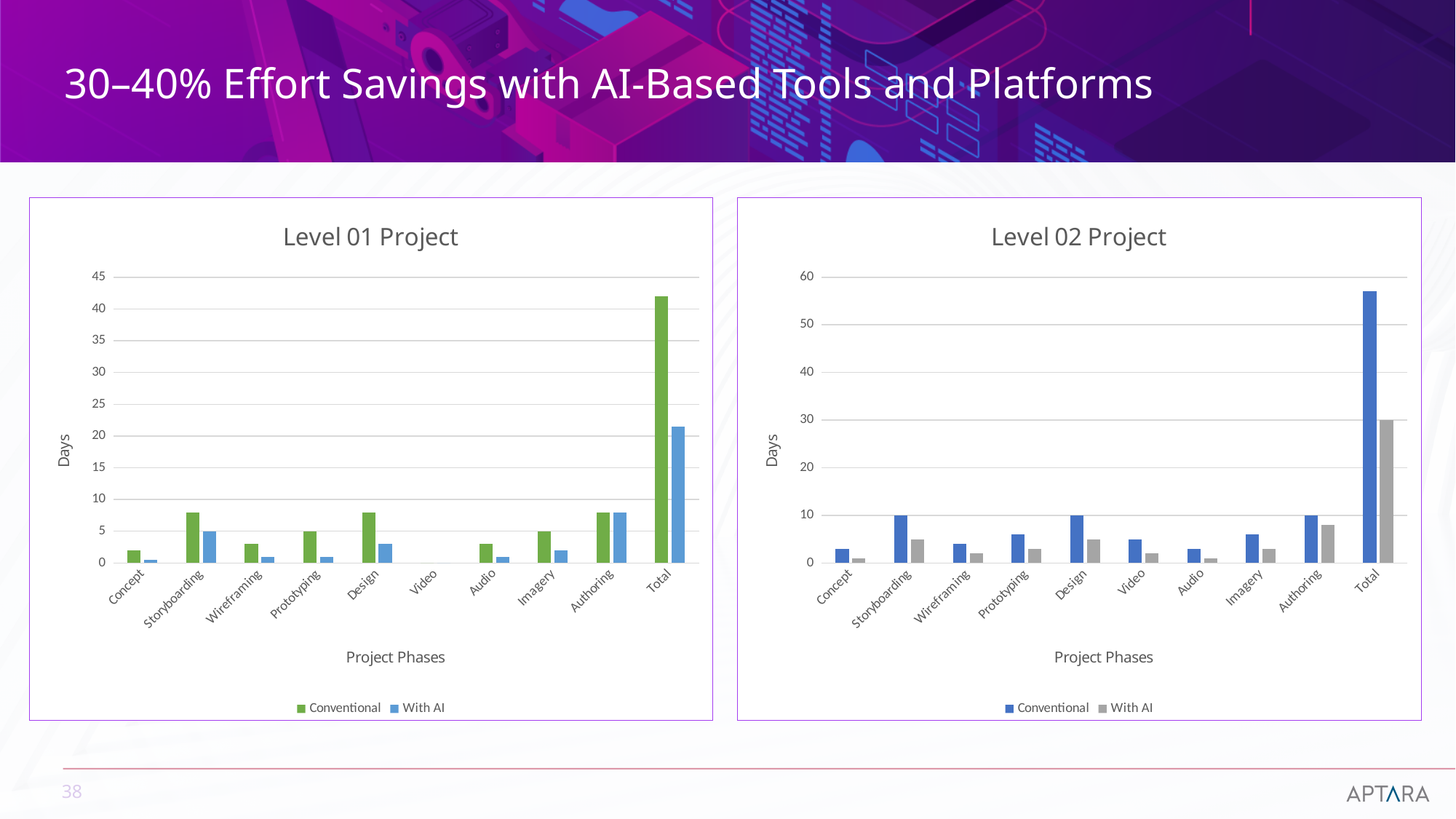
In the Level 01 Project chart, what is the Conventional value for Prototyping? 5 In the Level 02 Project chart, what is the With AI value for Total? 30 How many project phases are shown on the x axis of the Level 02 Project chart? 10 In the Level 01 Project chart, which project phase has the highest Conventional value? Total In the Level 02 Project chart, what is the Conventional value for Storyboarding? 10 What kind of chart is the Level 01 Project chart? Bar chart How many series does the legend of the Level 01 Project chart list? 2 In the Level 02 Project chart, is the Conventional value for Total greater or less than 50? greater In the Level 02 Project chart, which is larger for Authoring: Conventional or With AI? Conventional In the Level 01 Project chart, is the Conventional value for Total greater or less than 40? greater In the Level 01 Project chart, which is larger for Storyboarding: Conventional or With AI? Conventional In the Level 02 Project chart, which project phase has the highest With AI value? Total